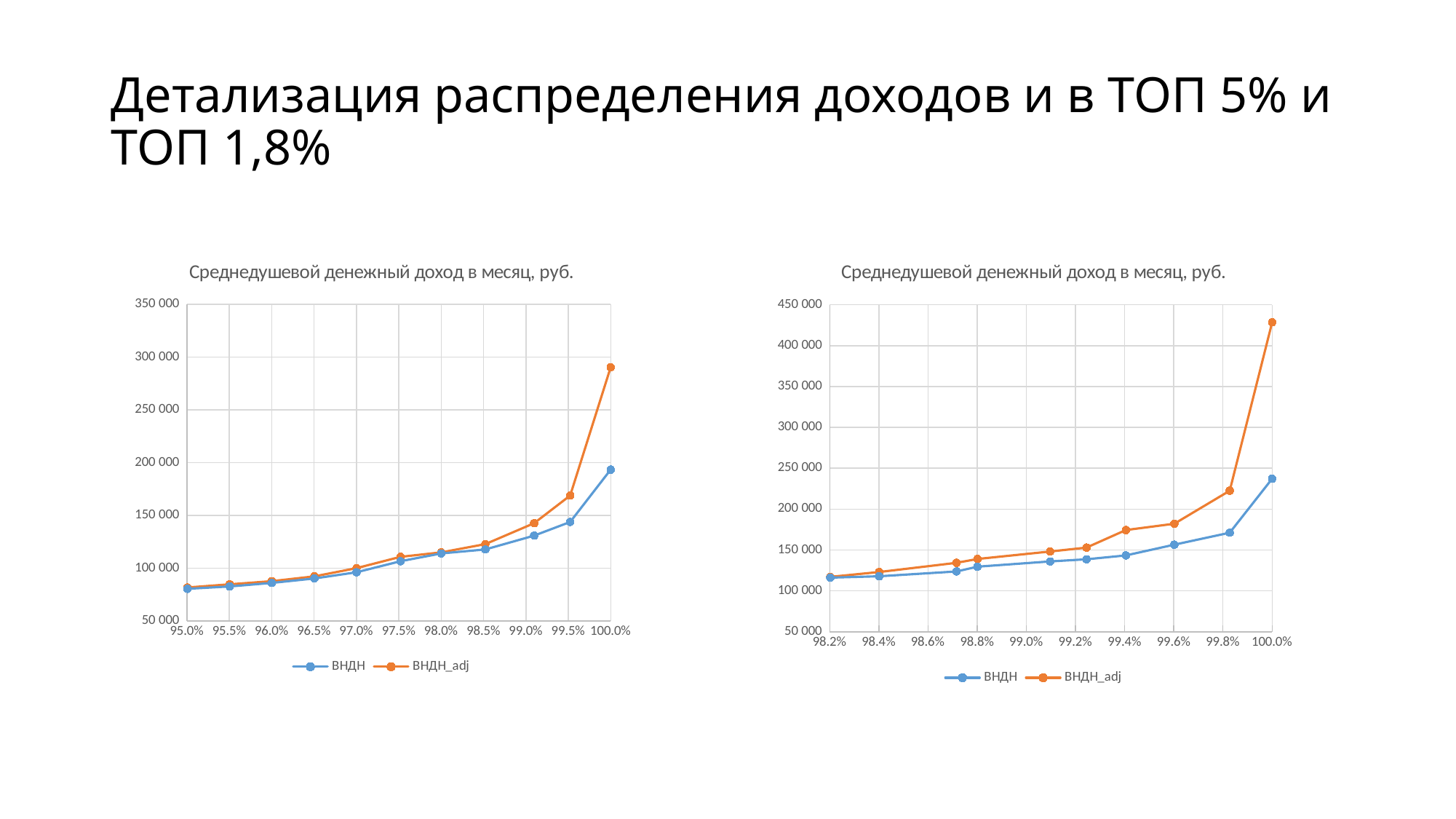
What kind of chart is the left chart on the slide? line chart How many x-axis categories does the left chart have? 11 In the left chart, is the ВНДН value at 100.0% greater or less than 200 000? less How many series does the legend of the right chart list? 2 In the left chart, is the ВНДН_adj value at 100.0% greater or less than 250 000? greater In the left chart, do the ВНДН_adj values rise or fall as the x axis goes from 95.0% to 100.0%? rise What is the title of the right chart? Среднедушевой денежный доход в месяц, руб. In the left chart, at which x-axis category does the ВНДН_adj series reach its highest value? 100.0% What are the two series named in the legend of the left chart? ВНДН and ВНДН_adj In the right chart, is the ВНДН_adj value at 100.0% greater or less than 400 000? greater In the right chart, which series has the higher value at 100.0%, ВНДН or ВНДН_adj? ВНДН_adj